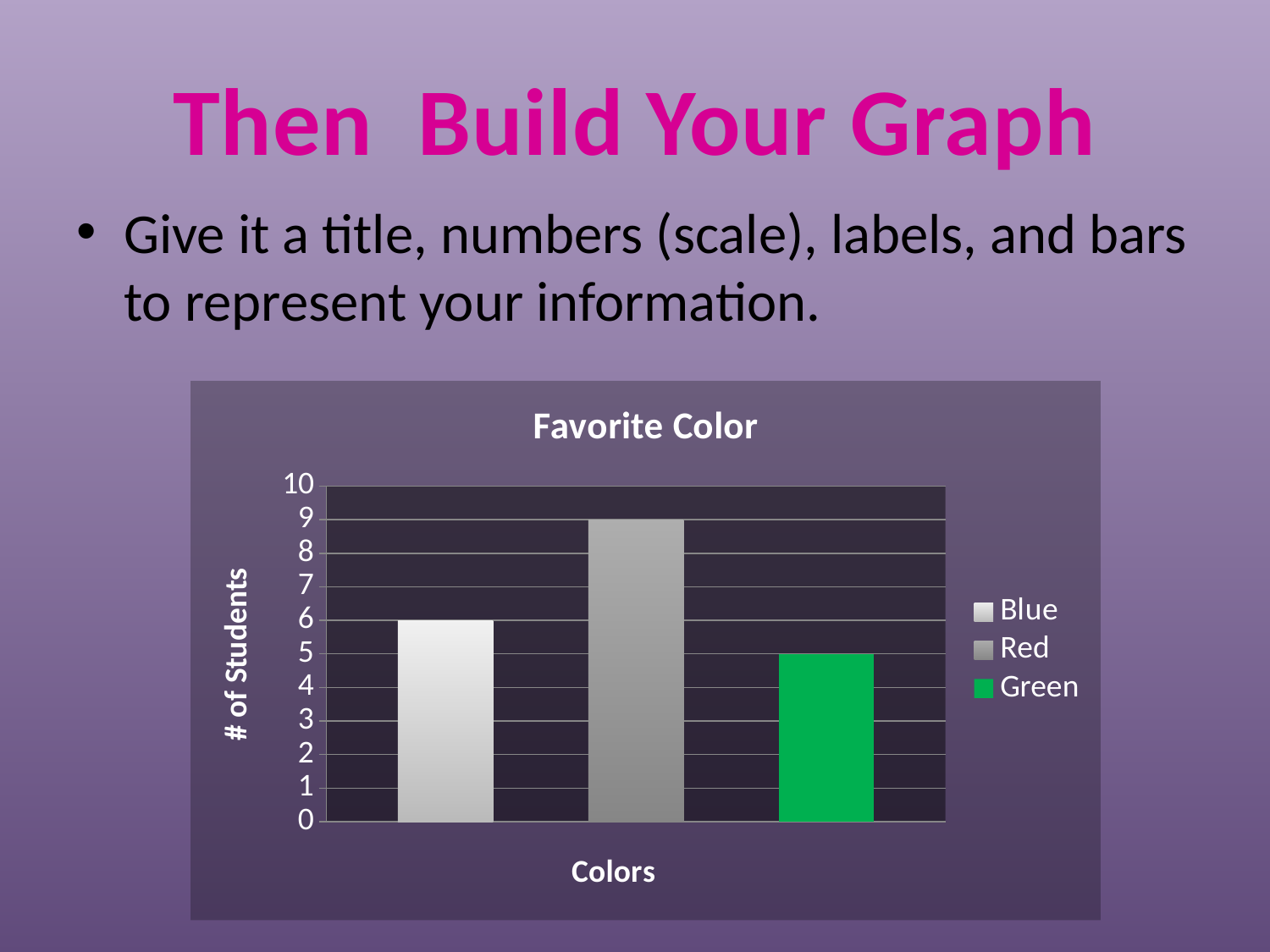
What is the value for Red in the Favorite Color chart? 9 What is the value for Green in the Favorite Color chart? 5 How many bars are shown in the Favorite Color chart? 3 What is the value for Blue in the Favorite Color chart? 6 Which color has the highest number of students in the Favorite Color chart? Red Which color has the lowest number of students in the Favorite Color chart? Green What is the difference between the values for Red and Blue in the Favorite Color chart? 3 What kind of chart is the Favorite Color chart? bar chart Is the value for Red in the Favorite Color chart greater or less than 8? greater What is the difference between the values for Blue and Green in the Favorite Color chart? 1 Which is larger in the Favorite Color chart, the value for Blue or the value for Green? Blue How many entries does the legend of the Favorite Color chart list? 3